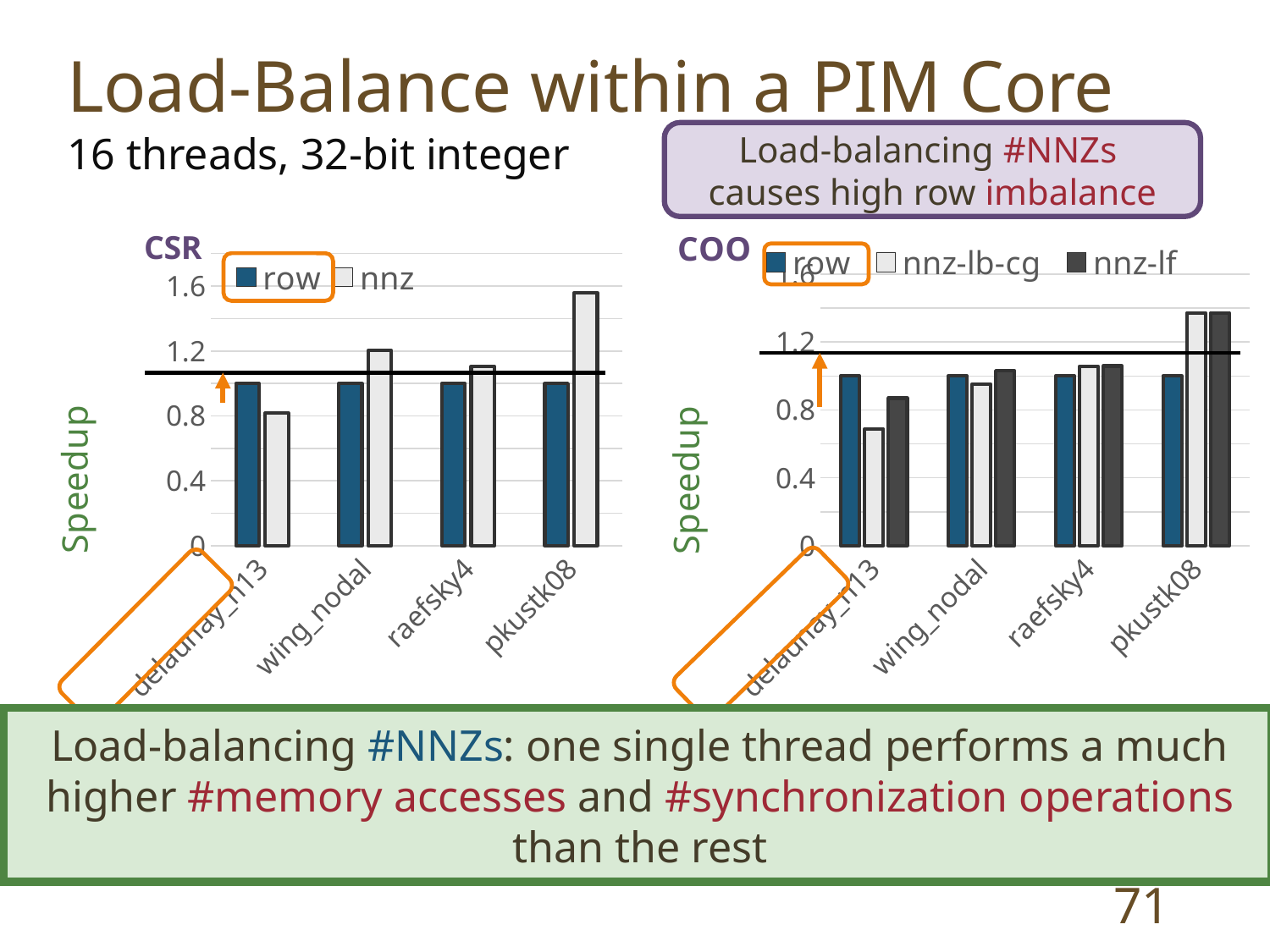
In the COO chart, for delaunay_n13, which is larger: nnz-lb-cg or nnz-lf? nnz-lf What kind of chart is the CSR chart on the left? bar chart In the CSR chart, is the nnz value for delaunay_n13 greater or less than 1.2? less How many categories are shown on the x axis of the CSR chart? 4 In the CSR chart, is the nnz value for pkustk08 greater or less than 1.2? greater How many series does the legend of the COO chart on the right list? 3 How many series does the legend of the CSR chart on the left list? 2 What is the y-axis label of the COO chart? Speedup In the CSR chart, which category has the lowest nnz bar? delaunay_n13 In the COO chart, is the nnz-lb-cg value for delaunay_n13 greater or less than 0.8? less In the CSR chart, which category has the highest nnz bar? pkustk08